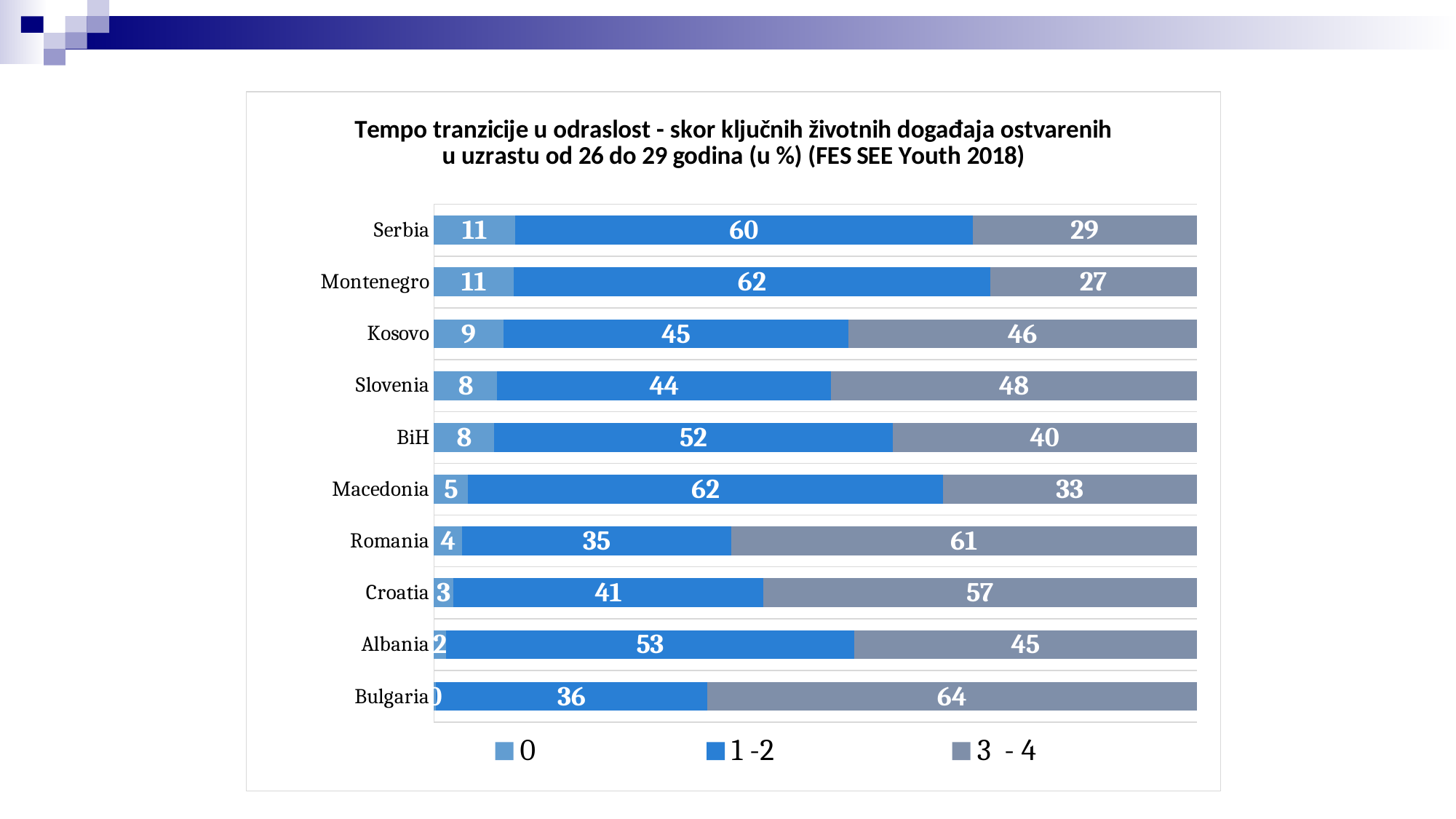
What is the value of the "3 - 4" series for Bulgaria? 64 How many countries are shown in the chart? 10 What is the value of the "0" series for Kosovo? 9 What is the difference between the "3 - 4" values for Romania and Serbia? 32 Which country has the lowest value in the "1 -2" series? Romania How many series does the legend list? 3 Which country has the highest value in the "3 - 4" series? Bulgaria What are the three legend entries of the chart? 0, 1 -2, 3 - 4 What is the value of the "1 -2" series for Serbia? 60 What kind of chart is shown on the slide? Stacked bar chart What is the total of the stacked bar for Slovenia? 100 Which is larger: the "1 -2" value for Montenegro or the "1 -2" value for BiH? Montenegro